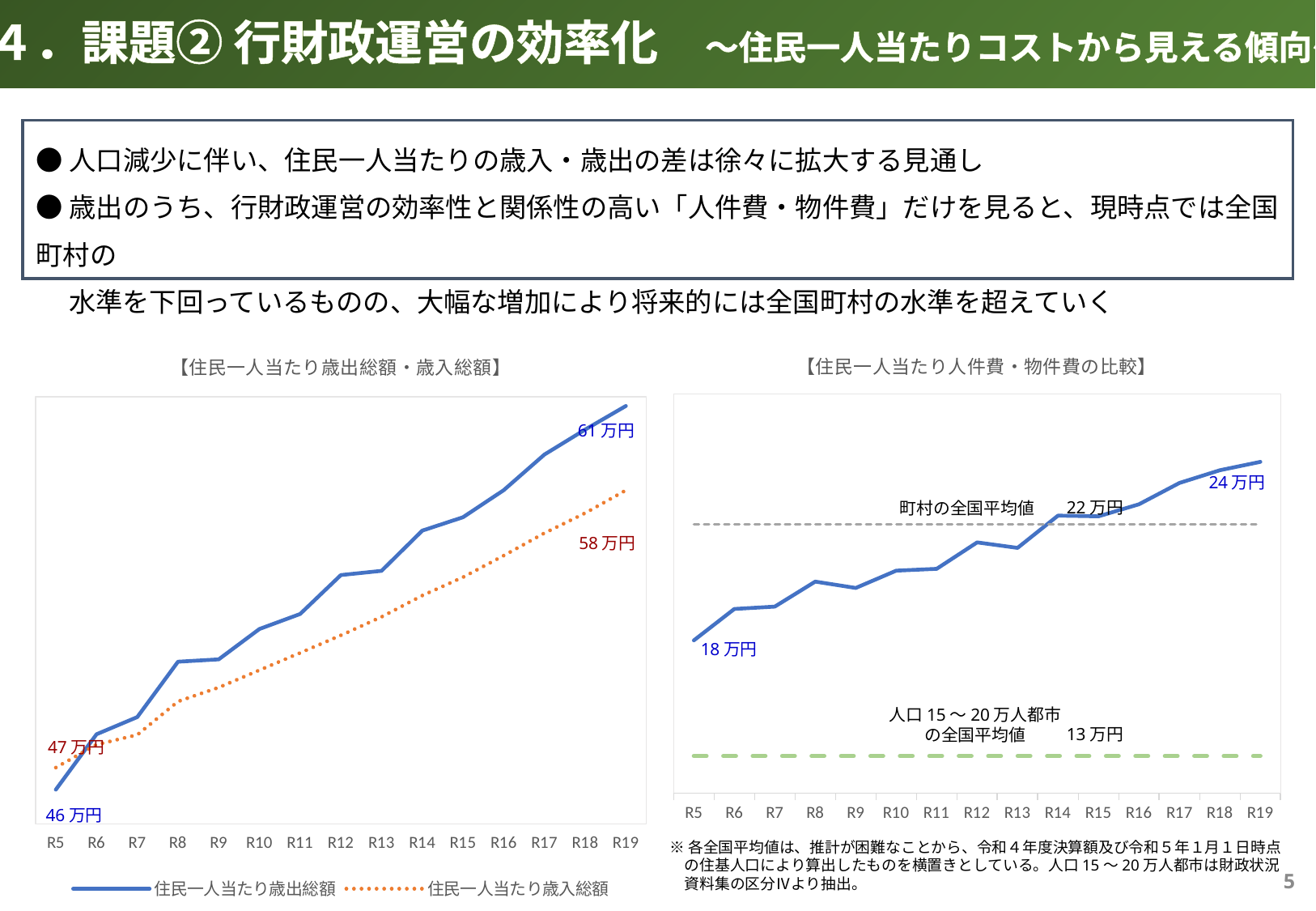
In the chart titled 【住民一人当たり歳出総額・歳入総額】, what is the value of 住民一人当たり歳入総額 at R5? 47万円 In the chart titled 【住民一人当たり歳出総額・歳入総額】, what is the value of 住民一人当たり歳出総額 at R5? 46万円 In the chart titled 【住民一人当たり歳出総額・歳入総額】, which series is larger at R19, 住民一人当たり歳出総額 or 住民一人当たり歳入総額? 住民一人当たり歳出総額 How many years are shown on the x axis of the chart titled 【住民一人当たり人件費・物件費の比較】? 15 In the chart titled 【住民一人当たり人件費・物件費の比較】, what is the value of 町村の全国平均値? 22万円 In the chart titled 【住民一人当たり人件費・物件費の比較】, what is the value of the blue line at R5? 18万円 In the chart titled 【住民一人当たり歳出総額・歳入総額】, what is the value of 住民一人当たり歳出総額 at R19? 61万円 In the chart titled 【住民一人当たり歳出総額・歳入総額】, does 住民一人当たり歳出総額 rise or fall from R5 to R19? Rise In the chart titled 【住民一人当たり歳出総額・歳入総額】, what is the difference between 住民一人当たり歳出総額 and 住民一人当たり歳入総額 at R19? 3万円 How many series does the legend of the chart titled 【住民一人当たり歳出総額・歳入総額】 list? 2 What kind of chart is the chart titled 【住民一人当たり歳出総額・歳入総額】? Line chart In the chart titled 【住民一人当たり人件費・物件費の比較】, what is the value of the blue line at R19? 24万円